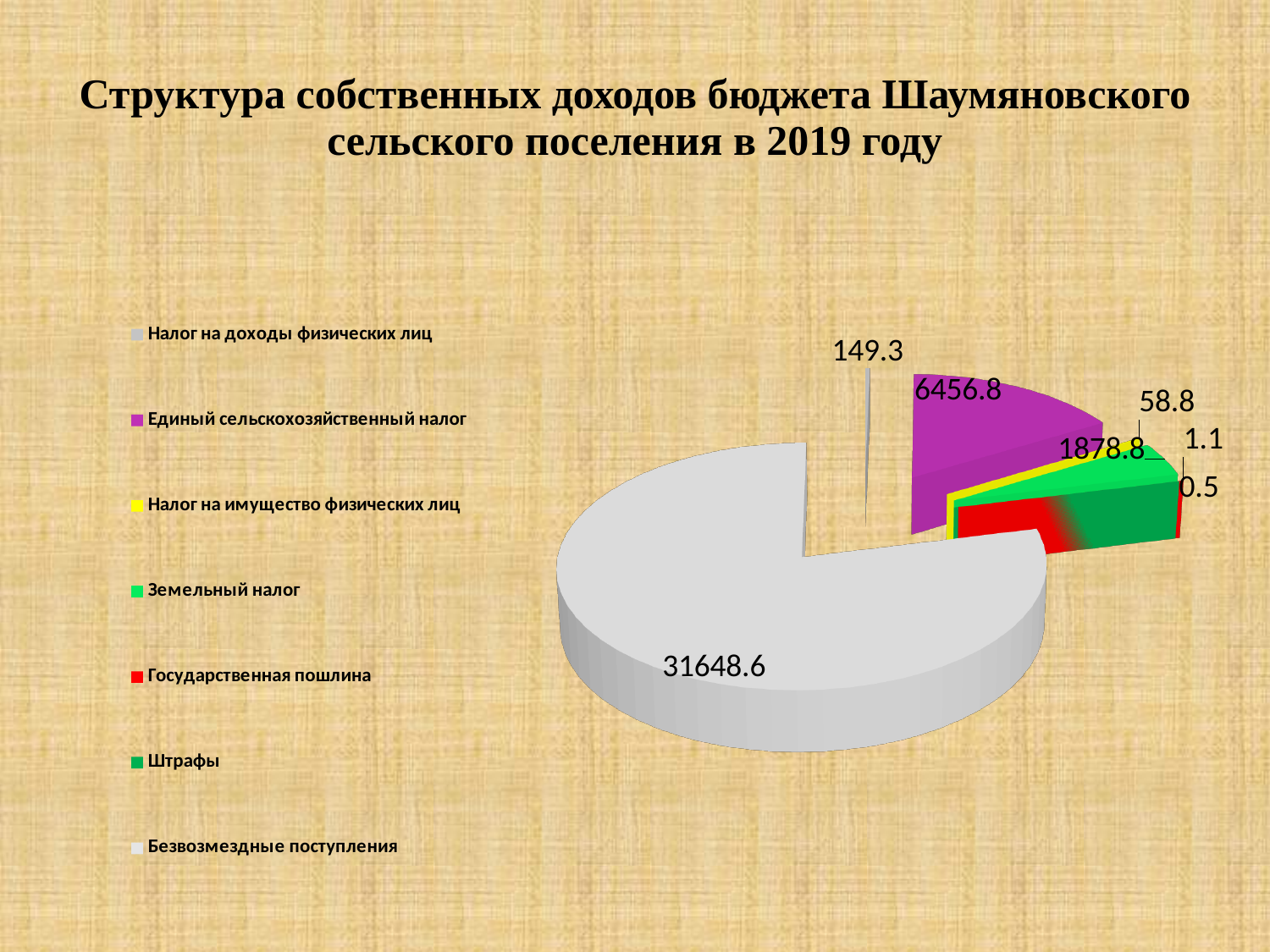
What colour is the slice for Единый сельскохозяйственный налог? purple What is the value labelled for Единый сельскохозяйственный налог? 6456.8 Which is larger, the value for Единый сельскохозяйственный налог or the value for Земельный налог? Единый сельскохозяйственный налог What is the difference between the values for Единый сельскохозяйственный налог and Земельный налог? 4578 What is the value labelled for Земельный налог? 1878.8 What is the value labelled for Налог на доходы физических лиц? 149.3 What is the value labelled for Безвозмездные поступления? 31648.6 What is the difference between the values for Безвозмездные поступления and Единый сельскохозяйственный налог? 25191.8 What is the smallest value labelled on the pie chart? 0.5 Which category has the largest slice of the pie? Безвозмездные поступления What kind of chart is shown on the slide? pie chart How many categories does the legend list? 7